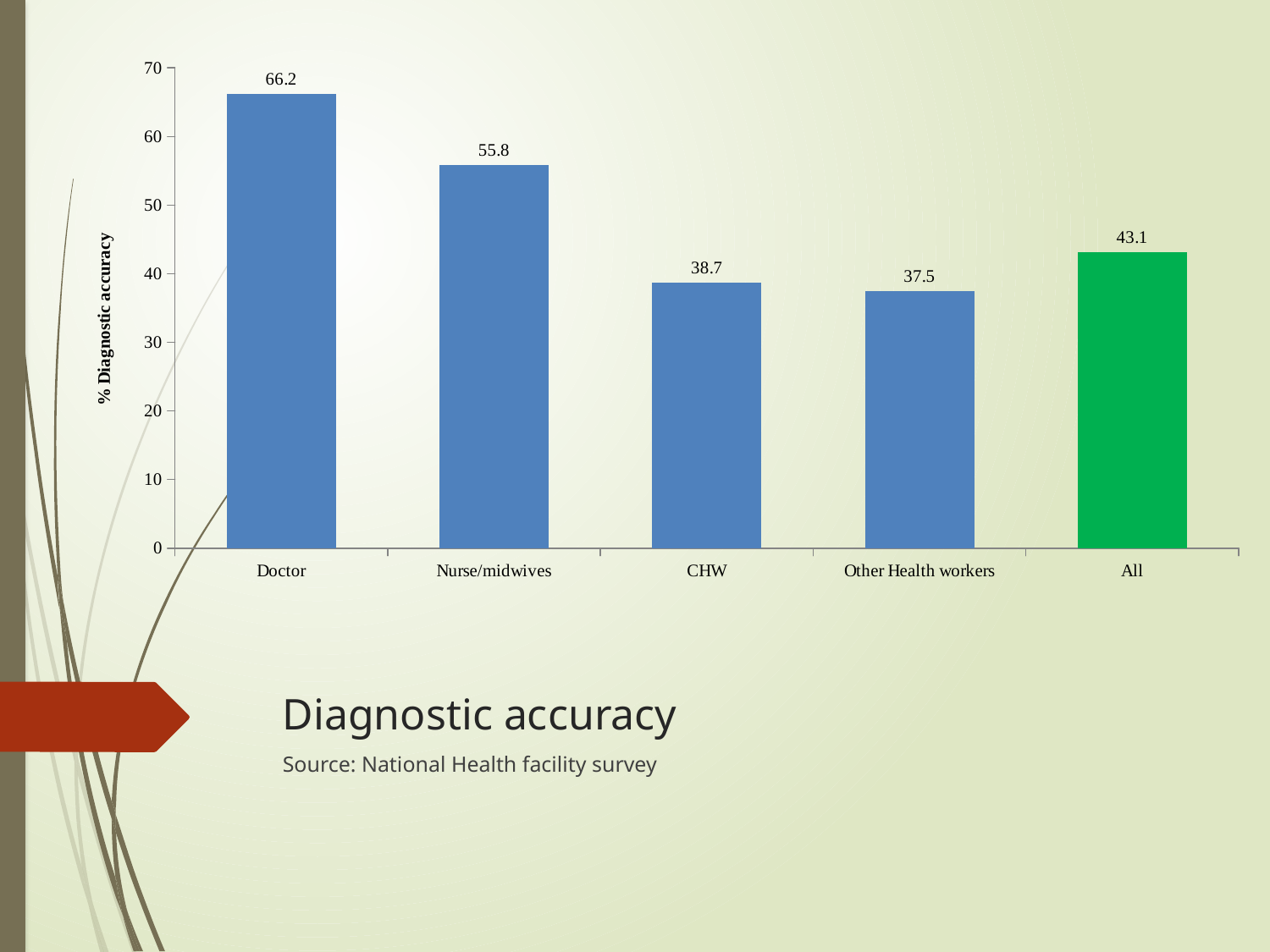
Which category has the lowest % diagnostic accuracy? Other Health workers What is the % diagnostic accuracy for Doctor? 66.2 What is the % diagnostic accuracy for Other Health workers? 37.5 How many categories are shown on the x axis? 5 What is the label of the y axis? % Diagnostic accuracy What is the % diagnostic accuracy for All? 43.1 Which category has the highest % diagnostic accuracy? Doctor What is the % diagnostic accuracy for CHW? 38.7 Which has a higher % diagnostic accuracy, CHW or All? All What is the difference in % diagnostic accuracy between Doctor and Nurse/midwives? 10.4 What is the % diagnostic accuracy for Nurse/midwives? 55.8 What kind of chart is shown on the slide? Bar chart